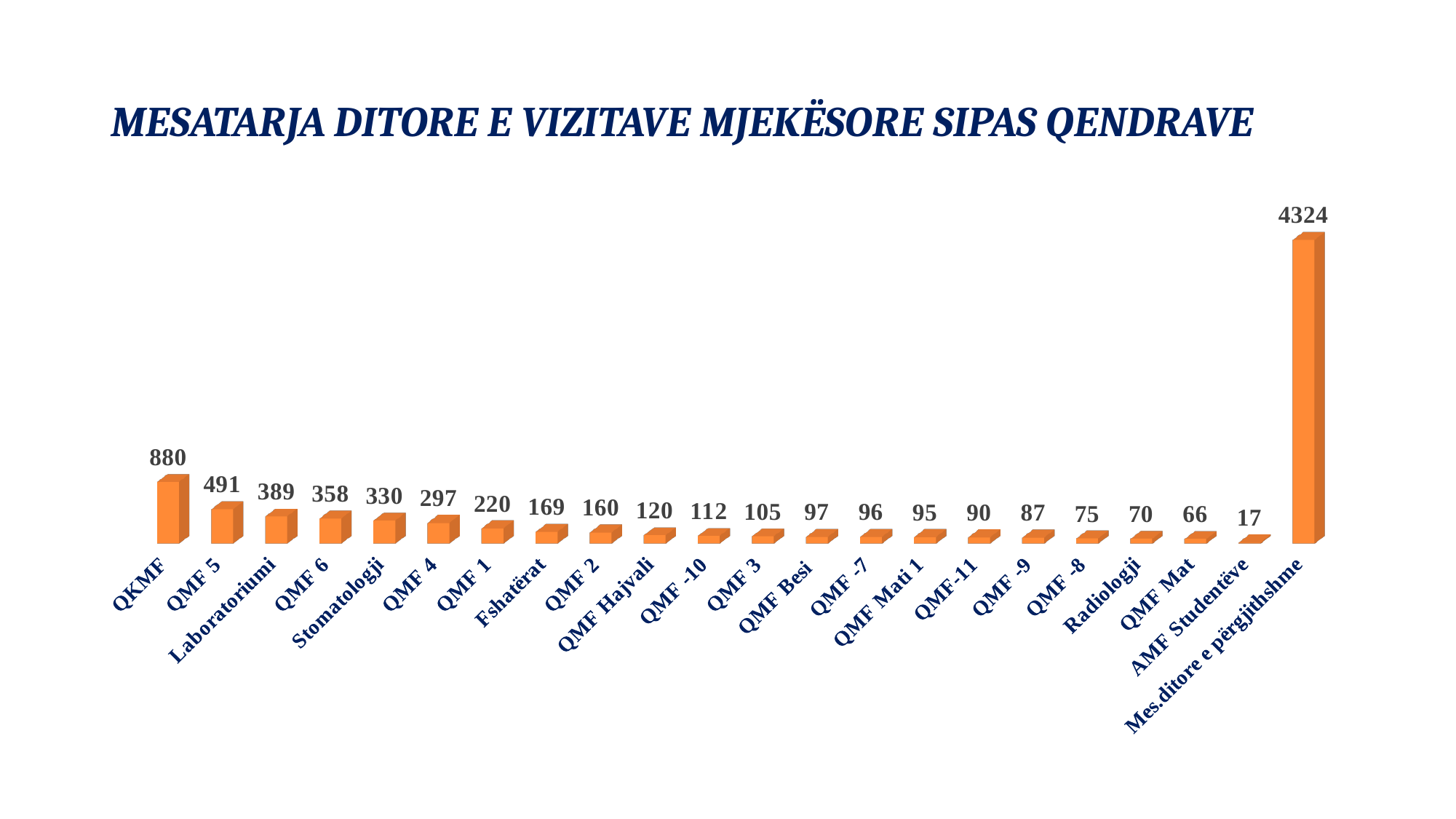
What is the difference between the values for QKMF and QMF 5? 389 What is the value for QKMF? 880 Which category has the highest value? Mes.ditore e përgjithshme What is the value for Stomatologji? 330 What is the title of the chart? MESATARJA DITORE E VIZITAVE MJEKËSORE SIPAS QENDRAVE Which is larger, the value for QMF 1 or the value for Fshatërat? QMF 1 What is the difference between the values for Laboratoriumi and QMF 6? 31 Which category has the lowest value? AMF Studentëve What is the value for QMF Hajvali? 120 What kind of chart is shown on the slide? Bar chart How many categories are shown on the x axis? 22 What is the value for Radiologji? 70